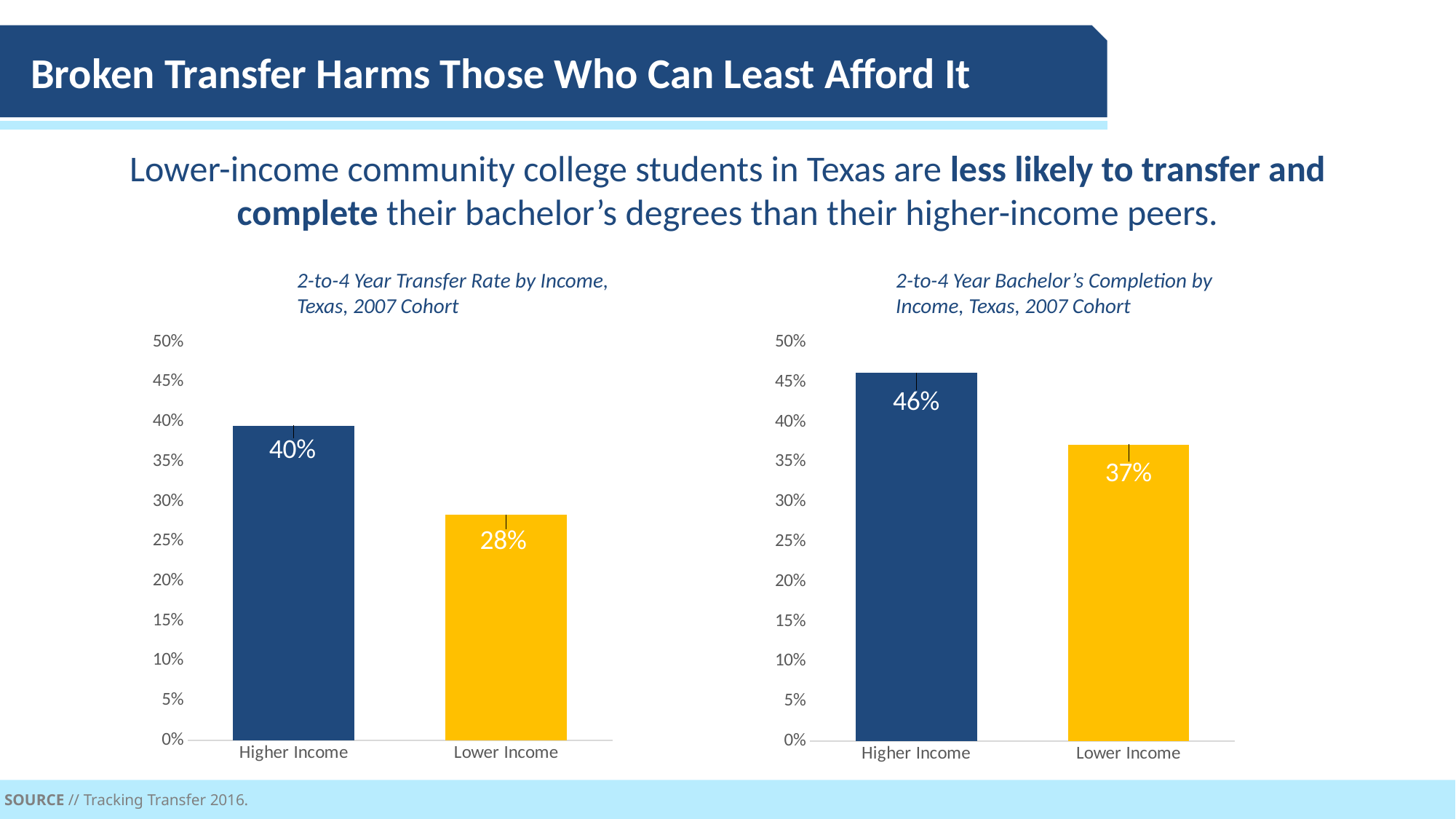
In the right chart (2-to-4 Year Bachelor's Completion by Income), what is the difference between the Higher Income and Lower Income values? 9% In the right chart (2-to-4 Year Bachelor's Completion by Income), is the value for Higher Income greater or less than 45%? greater In the left chart (2-to-4 Year Transfer Rate by Income), what is the difference between the Higher Income and Lower Income values? 12% In the right chart (2-to-4 Year Bachelor's Completion by Income, Texas, 2007 Cohort), what is the value for Lower Income? 37% How many categories are shown in the left chart (2-to-4 Year Transfer Rate by Income)? 2 In the left chart (2-to-4 Year Transfer Rate by Income), which category has the highest value? Higher Income In the right chart (2-to-4 Year Bachelor's Completion by Income, Texas, 2007 Cohort), what is the value for Higher Income? 46% In the left chart (2-to-4 Year Transfer Rate by Income, Texas, 2007 Cohort), what is the value for Lower Income? 28% In the left chart (2-to-4 Year Transfer Rate by Income), what colour is the Lower Income bar? Yellow What kind of chart is the right chart (2-to-4 Year Bachelor's Completion by Income)? Bar chart In the right chart (2-to-4 Year Bachelor's Completion by Income), which category has the lowest value? Lower Income In the left chart (2-to-4 Year Transfer Rate by Income, Texas, 2007 Cohort), what is the value for Higher Income? 40%